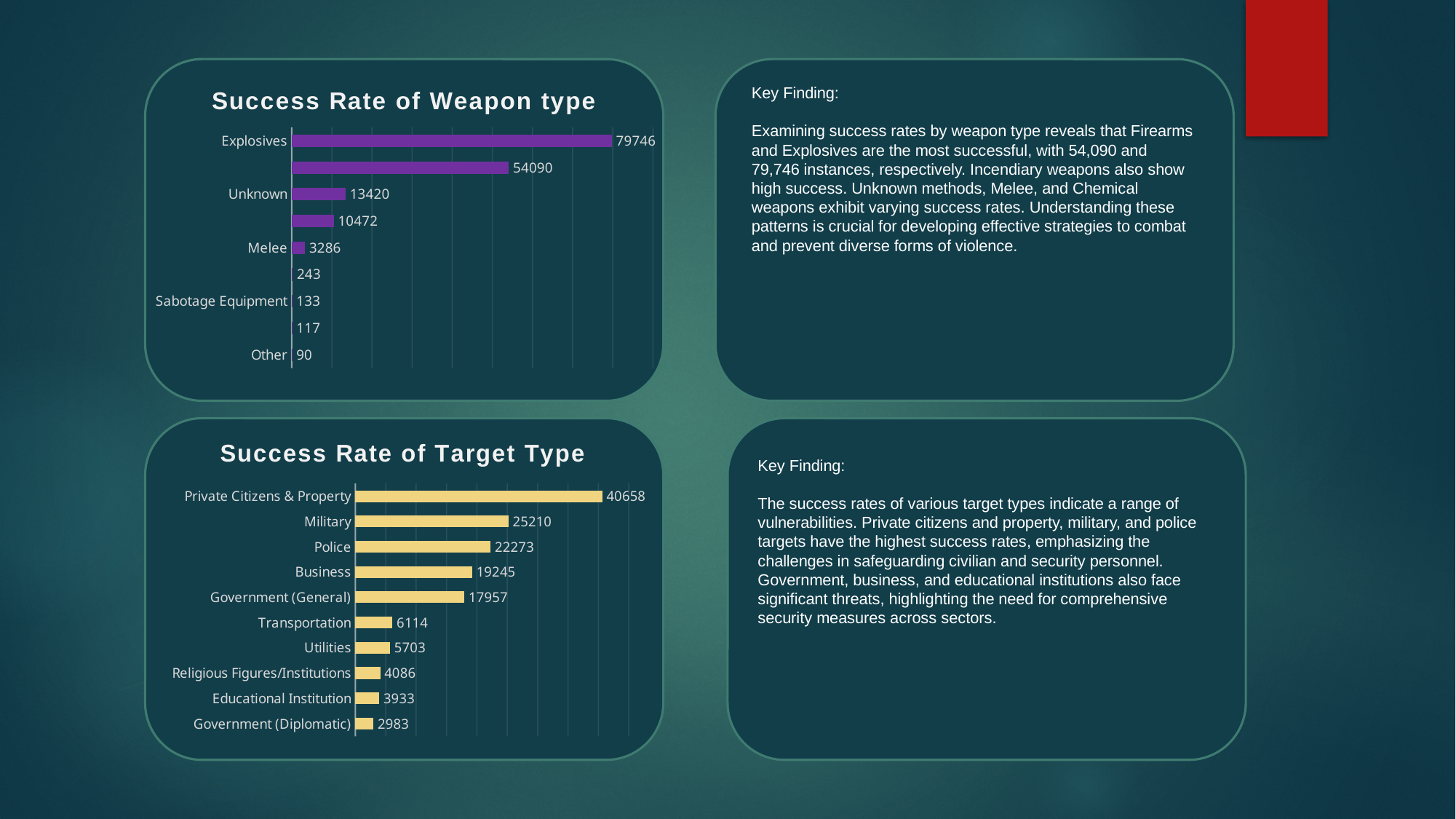
What type of chart is 'Success Rate of Target Type'? Bar chart In the 'Success Rate of Target Type' chart, what is the value for Police? 22273 In the 'Success Rate of Weapon type' chart, how many bars are plotted? 9 In the 'Success Rate of Weapon type' chart, what is the value for Melee? 3286 In the 'Success Rate of Target Type' chart, what is the difference between Military and Business? 5965 In the 'Success Rate of Target Type' chart, which category has the lowest value? Government (Diplomatic) In the 'Success Rate of Target Type' chart, which is larger: Transportation or Utilities? Transportation In the 'Success Rate of Target Type' chart, which category has the highest value? Private Citizens & Property In the 'Success Rate of Weapon type' chart, which category has the lowest value? Other In the 'Success Rate of Weapon type' chart, what is the difference between Unknown and Melee? 10134 In the 'Success Rate of Weapon type' chart, what is the value for Sabotage Equipment? 133 In the 'Success Rate of Weapon type' chart, what is the value for Explosives? 79746